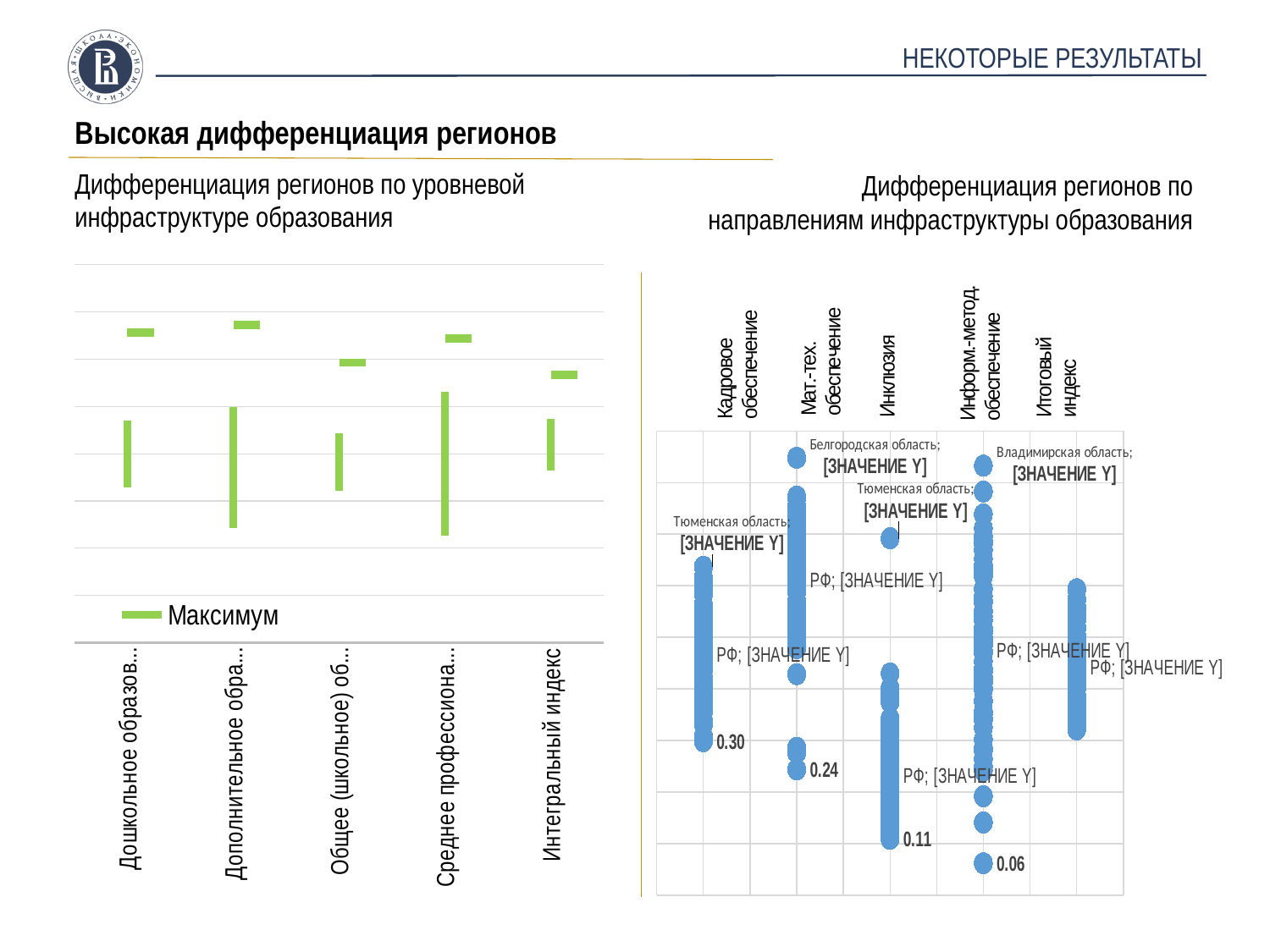
On the right chart, which region is labelled at the top point of Мат.-тех. обеспечение? Белгородская область On the left chart, what is the only entry in the legend? Максимум On the right chart, what is the lowest labelled value for Информ.-метод. обеспечение? 0.06 On the right chart (Дифференциация регионов по направлениям инфраструктуры образования), how many directions are listed along the x axis? 5 On the left chart (Дифференциация регионов по уровневой инфраструктуре образования), how many categories are shown on the x axis? 5 On the right chart, what is the lowest labelled value for Кадровое обеспечение? 0.30 On the right chart, which direction has the lowest labelled minimum value? Информ.-метод. обеспечение On the left chart, which category has the lowest 'Максимум' marker? Интегральный индекс On the right chart, what is the lowest labelled value for Мат.-тех. обеспечение? 0.24 On the right chart, what is the difference between the lowest labelled value for Кадровое обеспечение (0.30) and for Информ.-метод. обеспечение (0.06)? 0.24 On the right chart, which is larger: the lowest labelled value for Мат.-тех. обеспечение or for Инклюзия? Мат.-тех. обеспечение On the right chart, what is the lowest labelled value for Инклюзия? 0.11